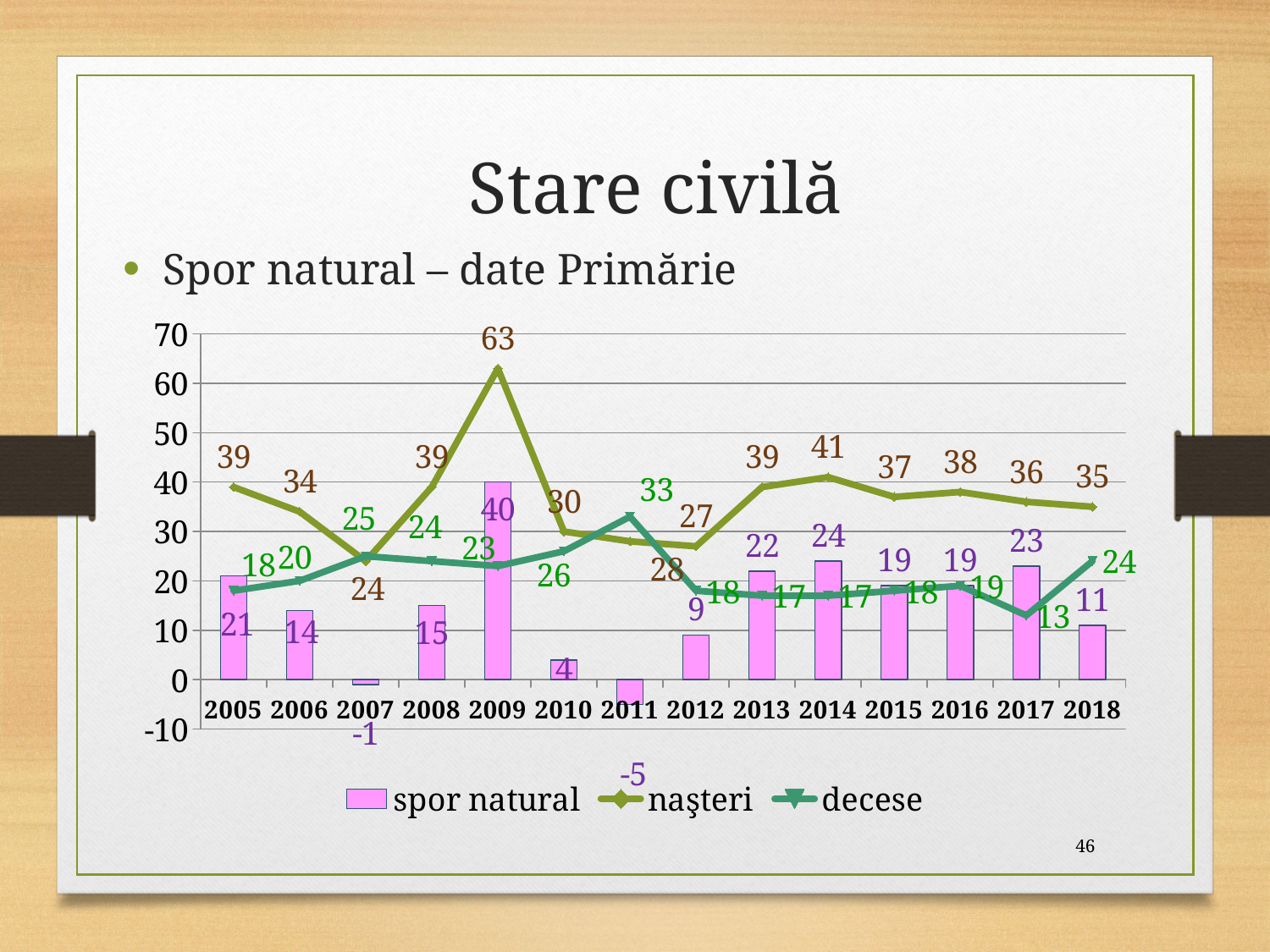
In which year is decese highest? 2011 Does naşteri rise or fall from 2014 to 2018? fall What kind of chart is used for the spor natural series? bar chart What is the value of naşteri in 2009? 63 What is the value of decese in 2017? 13 How many series does the legend list? 3 In which year is spor natural lowest? 2011 What is the value of spor natural in 2011? -5 What is the difference between naşteri and decese in 2014? 24 How many years are shown on the x axis? 14 Which is larger in 2007, naşteri or decese? decese In which year is naşteri highest? 2009